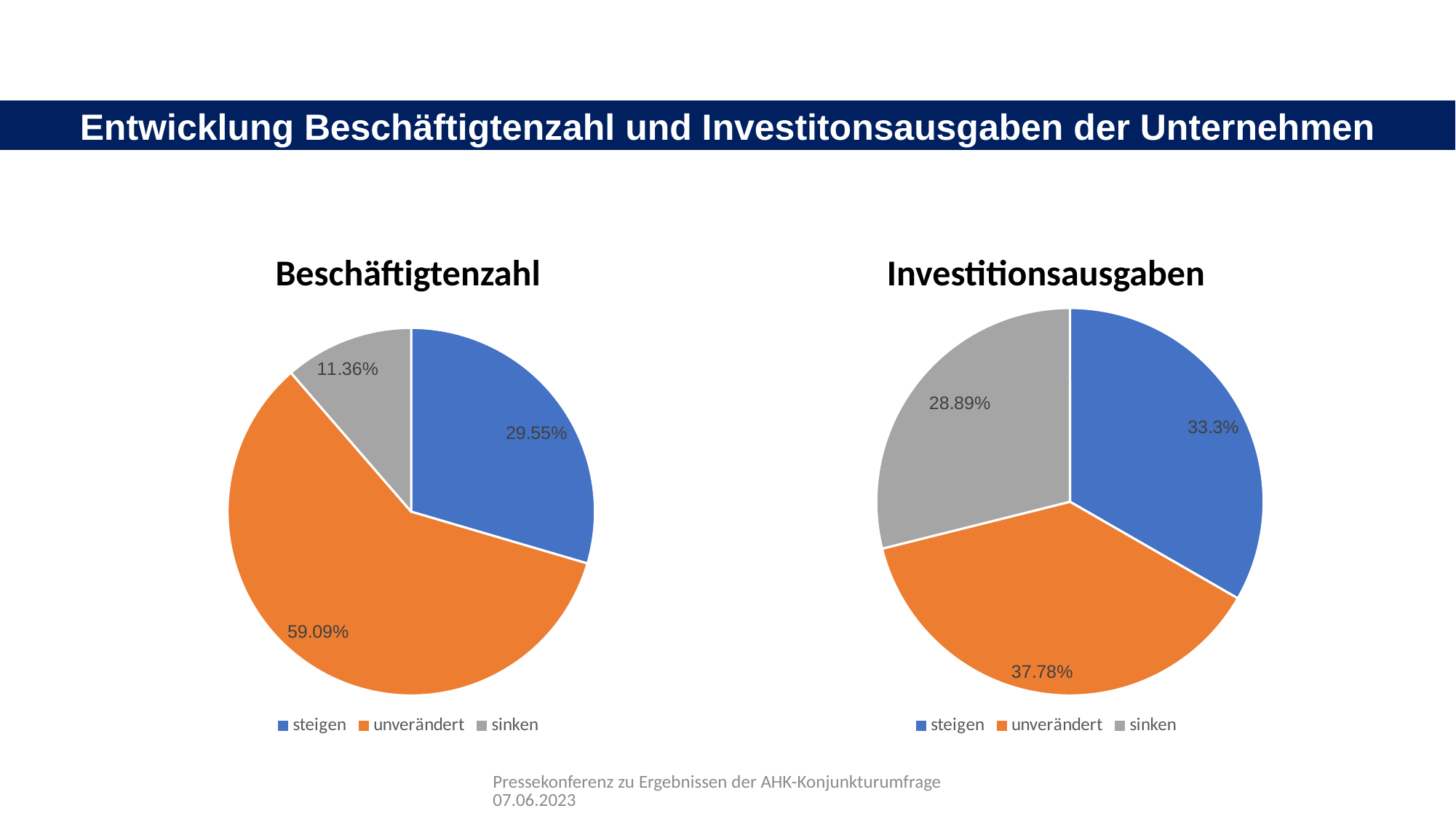
In the Beschäftigtenzahl chart, what is the value for unverändert? 59.09% In the Investitionsausgaben chart, which is larger, the share for steigen or the share for sinken? steigen In the Investitionsausgaben chart, what is the value for sinken? 28.89% In the Beschäftigtenzahl chart, which category has the largest share? unverändert In the Beschäftigtenzahl chart, what is the difference between the shares for unverändert and steigen? 29.54% How many categories does the legend of the Investitionsausgaben chart list? 3 In the Beschäftigtenzahl chart, which category has the smallest share? sinken In the Beschäftigtenzahl chart, what is the value for sinken? 11.36% In the Investitionsausgaben chart, which category has the smallest share? sinken In the Investitionsausgaben chart, what is the value for steigen? 33.3% What kind of chart is the Beschäftigtenzahl chart? pie chart In the Investitionsausgaben chart, which category has the largest share? unverändert